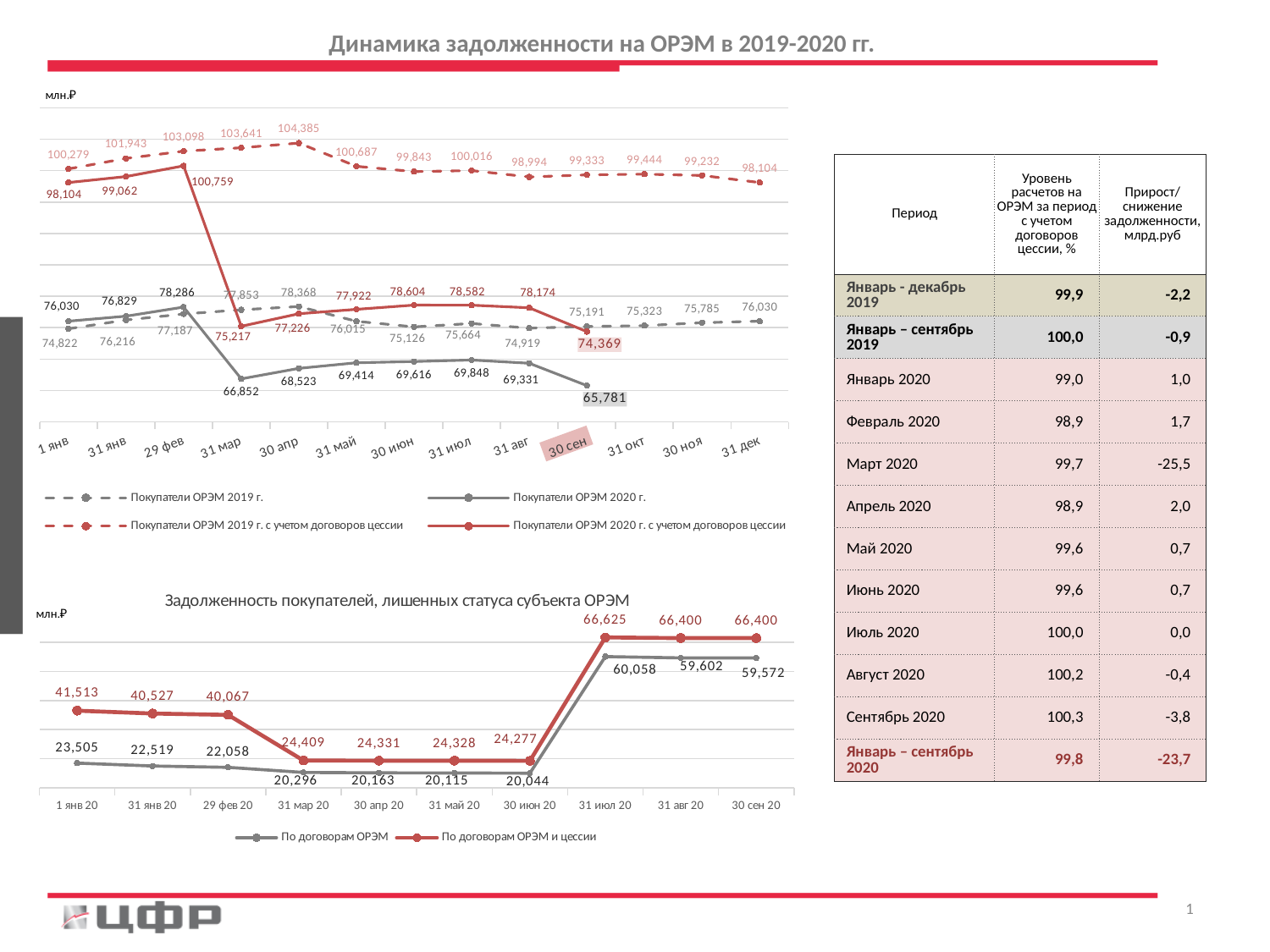
In the bottom chart 'Задолженность покупателей, лишенных статуса субъекта ОРЭМ', what is the value of 'По договорам ОРЭМ' on 1 янв 20? 23,505 In the bottom chart 'Задолженность покупателей, лишенных статуса субъекта ОРЭМ', what is the difference between 'По договорам ОРЭМ и цессии' and 'По договорам ОРЭМ' on 30 сен 20? 6,828 In the bottom chart 'Задолженность покупателей, лишенных статуса субъекта ОРЭМ', what is the value of 'По договорам ОРЭМ и цессии' on 31 июл 20? 66,625 How many series does the legend of the top chart list? 4 In the top chart, which is larger at 31 мар: 'Покупатели ОРЭМ 2019 г.' or 'Покупатели ОРЭМ 2020 г.'? Покупатели ОРЭМ 2019 г. In the bottom chart 'Задолженность покупателей, лишенных статуса субъекта ОРЭМ', does 'По договорам ОРЭМ и цессии' rise or fall from 1 янв 20 to 30 июн 20? Fall In the top chart, at which date does 'Покупатели ОРЭМ 2020 г. с учетом договоров цессии' reach its highest value? 29 фев How many dates are shown on the x axis of the bottom chart 'Задолженность покупателей, лишенных статуса субъекта ОРЭМ'? 10 In the bottom chart 'Задолженность покупателей, лишенных статуса субъекта ОРЭМ', at which date is 'По договорам ОРЭМ' lowest? 30 июн 20 What type of chart is the bottom chart 'Задолженность покупателей, лишенных статуса субъекта ОРЭМ'? Line chart In the top chart, what is the value of 'Покупатели ОРЭМ 2019 г. с учетом договоров цессии' at 30 апр? 104,385 In the top chart, what is the value of 'Покупатели ОРЭМ 2020 г.' at 30 сен? 65,781